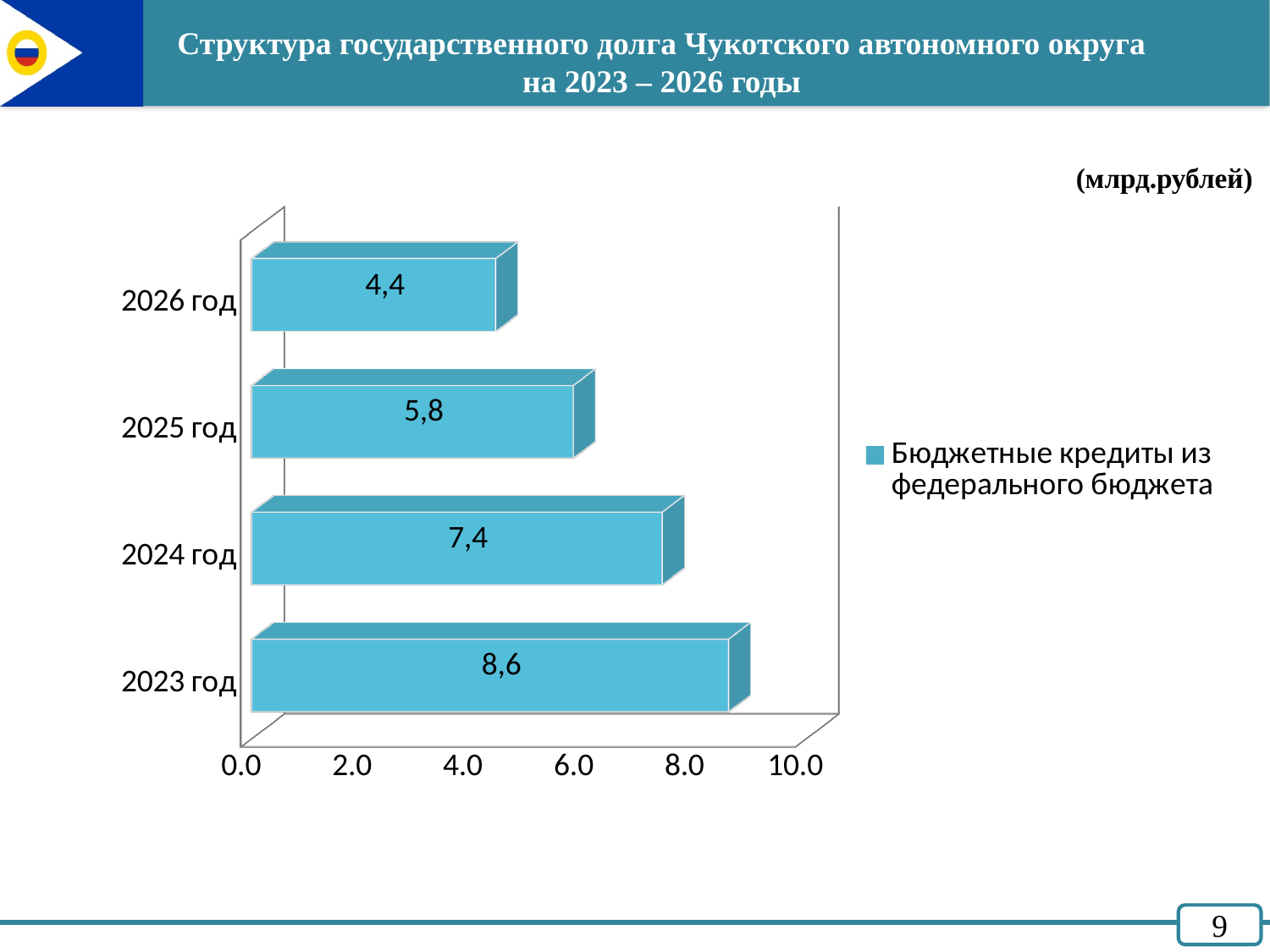
Which is larger, the value for 2024 год or the value for 2025 год? 2024 год How many years are shown in the chart? 4 Which year has the highest value? 2023 год What series name is shown in the legend? Бюджетные кредиты из федерального бюджета What kind of chart is shown on the slide? bar chart How many series does the legend list? 1 What is the value for 2026 год? 4,4 What is the value for 2023 год? 8,6 What is the difference between the values for 2024 год and 2025 год? 1,6 What is the difference between the values for 2023 год and 2026 год? 4,2 Which year has the lowest value? 2026 год What is the value for 2025 год? 5,8